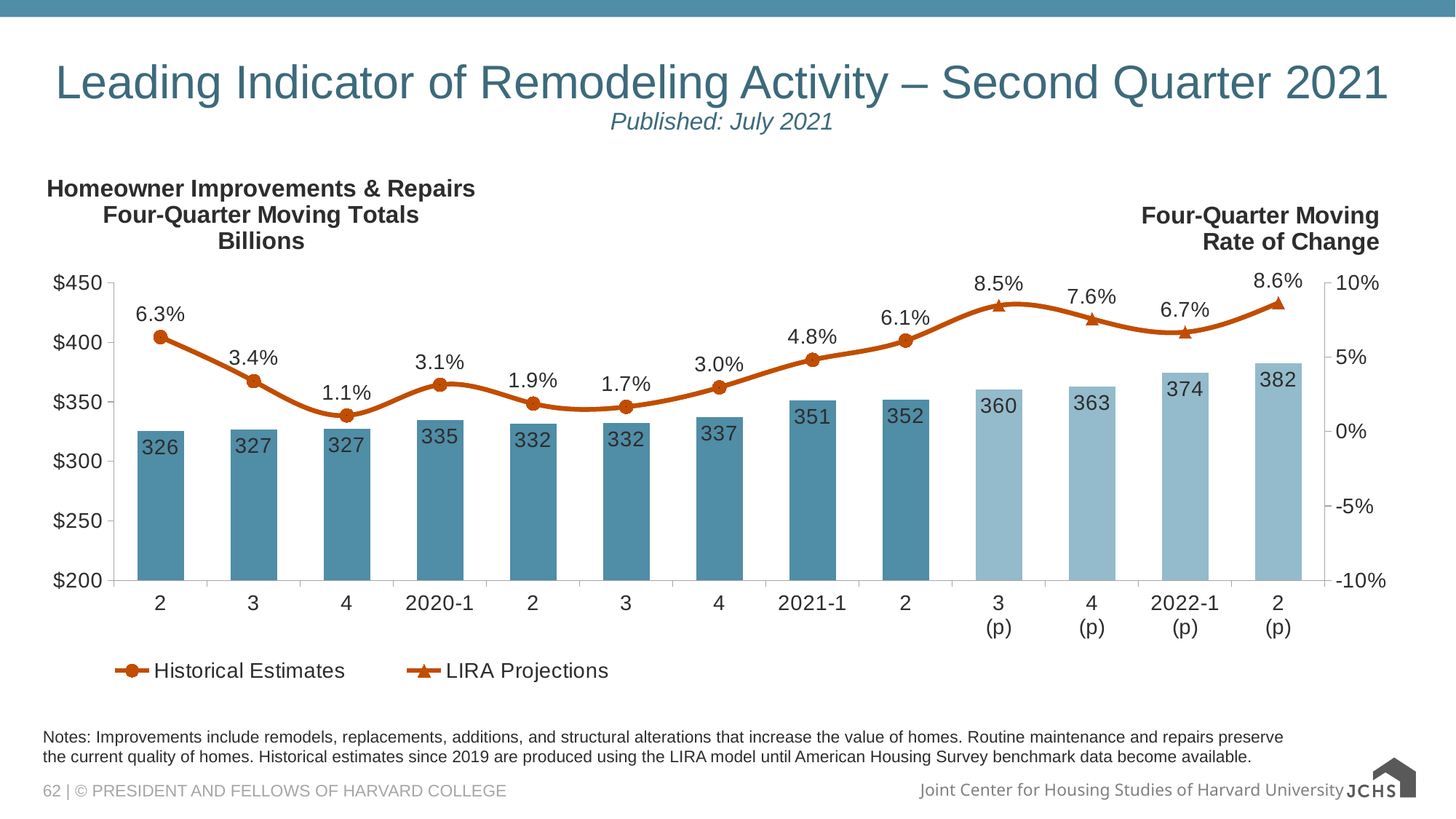
What is the difference between the four-quarter moving totals for 2 (p) of 2022 and 2 of 2021? 30 Do the four-quarter moving totals rise or fall from 2021-1 to 2 (p) of 2022? Rise Which quarter has the highest four-quarter moving rate of change? 2 (p) of 2022 Which quarter has the highest four-quarter moving total? 2 (p) of 2022 How many series does the legend list? 2 What is the projected four-quarter moving total for 2022-1 (p)? 374 What is the four-quarter moving total (in billions) for 2021-1? 351 What is the four-quarter moving rate of change for 2020-1? 3.1% How many quarters are shown on the x axis? 13 What kind of chart is this? Combined bar and line chart Which quarter has the lowest four-quarter moving rate of change? 4 of 2019 Is the four-quarter moving rate of change higher in 2021-1 or in 2 of 2021? 2 of 2021